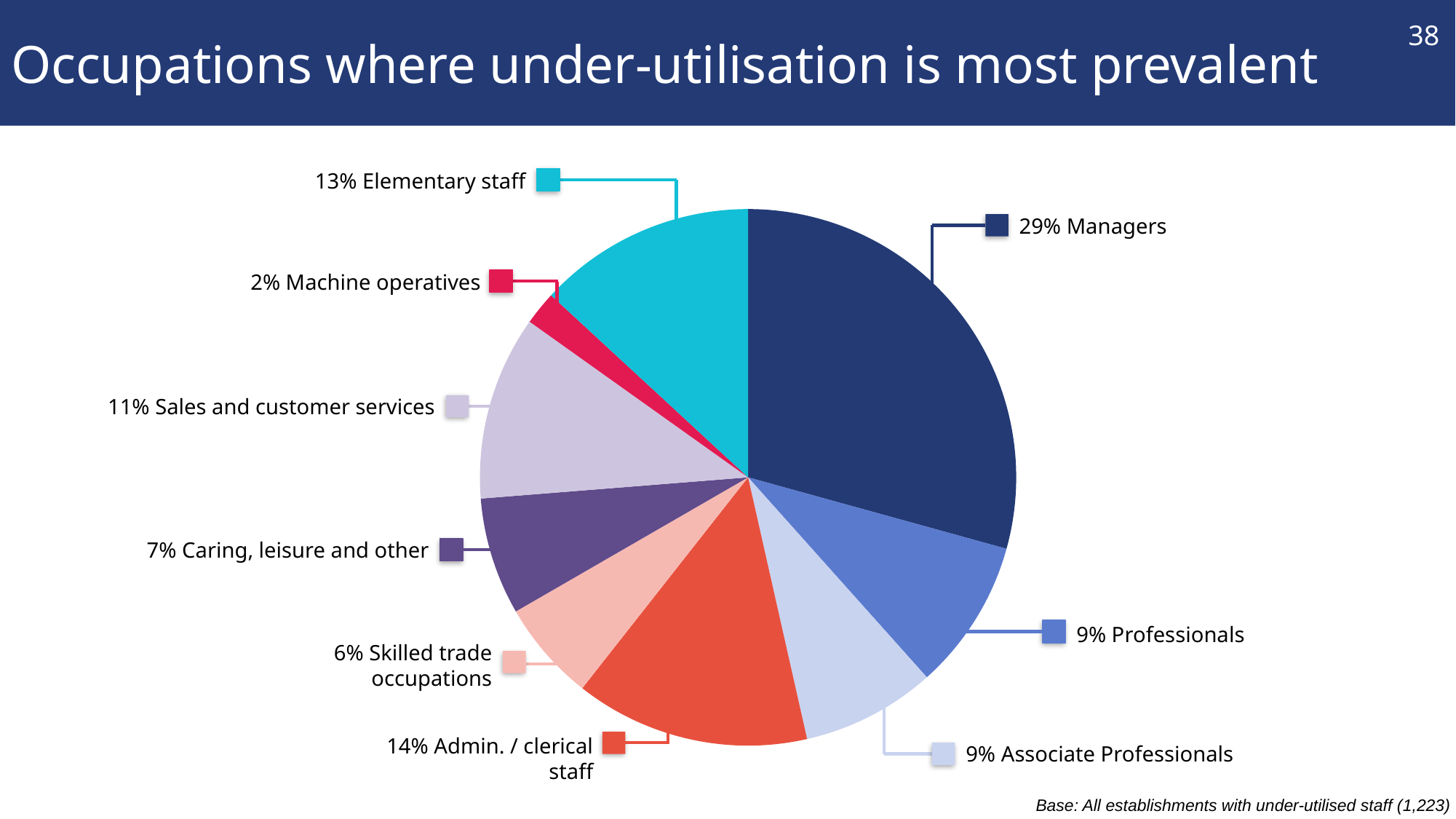
What kind of chart is shown on the slide? pie chart What is the base stated below the chart? All establishments with under-utilised staff (1,223) Which is larger, the share for Caring, leisure and other or the share for Skilled trade occupations? Caring, leisure and other Which occupation has the smallest share of the pie? Machine operatives What share of the pie is Managers? 29% How many slices does the pie chart have? 9 What is the title of the slide? Occupations where under-utilisation is most prevalent Which occupation has the largest share of the pie? Managers What is the value for Admin. / clerical staff? 14% What is the value for Sales and customer services? 11% What is the difference between the shares for Managers and Admin. / clerical staff? 15% What is the value for Elementary staff? 13%